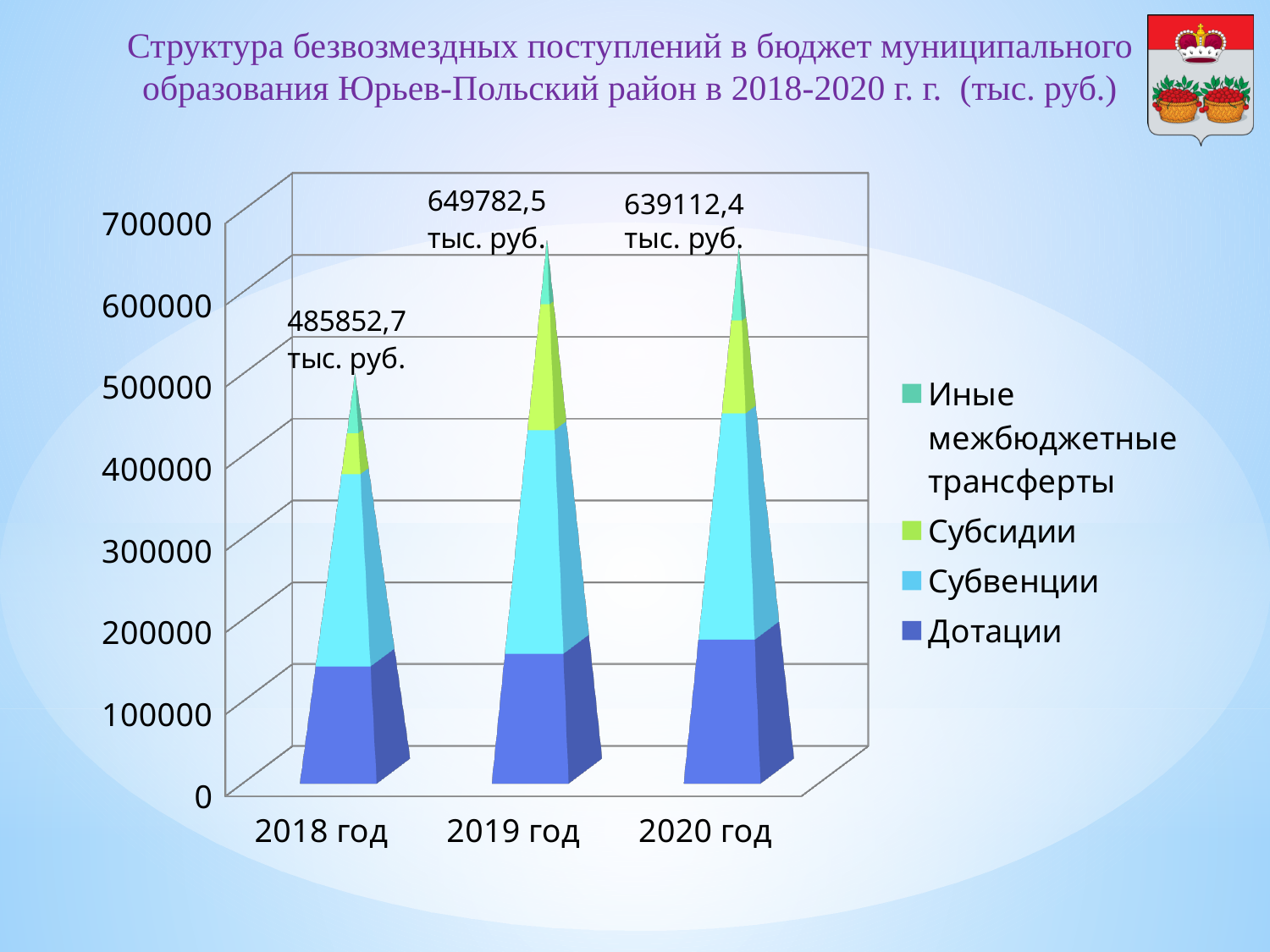
How many years are shown on the x axis? 3 What is the difference between the labelled totals for 2019 год and 2018 год? 163929,8 тыс. руб. What is the total value labelled for 2019 год? 649782,5 тыс. руб. What is the difference between the labelled totals for 2019 год and 2020 год? 10670,1 тыс. руб. Which year has the lowest total of безвозмездные поступления? 2018 год What is the total value labelled for 2018 год? 485852,7 тыс. руб. What is the total value labelled for 2020 год? 639112,4 тыс. руб. Is the value of Дотации for 2018 год greater or less than 200000? less Which year has the highest total of безвозмездные поступления? 2019 год Which is larger, the total for 2018 год or the total for 2020 год? 2020 год What kind of chart is shown on the slide? stacked bar chart How many series does the legend list? 4